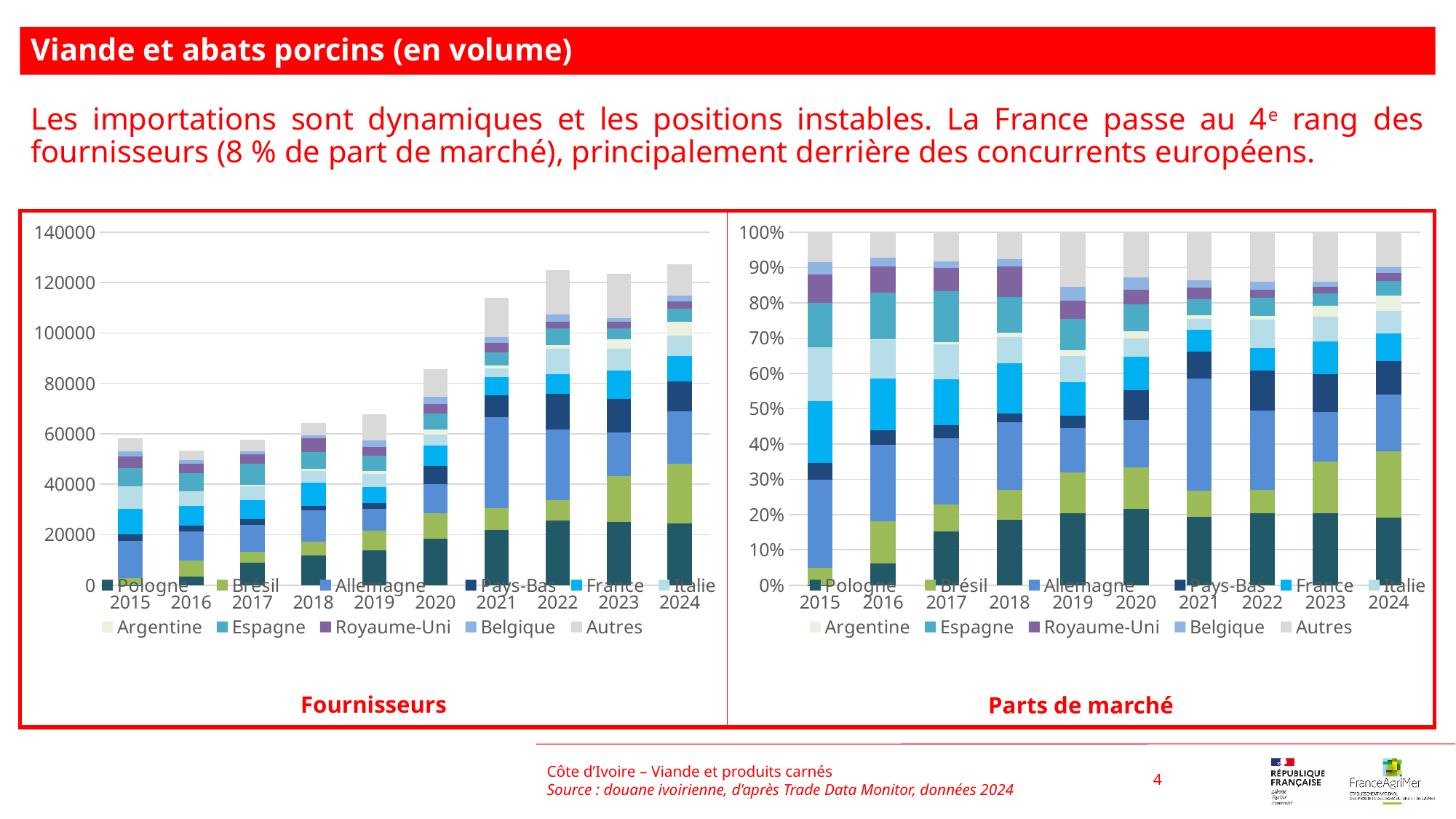
In the 'Fournisseurs' chart, do the total stacked values generally rise or fall from 2015 to 2024? rise In the 'Fournisseurs' chart, which year has a larger total stacked value, 2019 or 2021? 2021 Which series is listed last in the legend of the 'Fournisseurs' chart? Autres What kind of chart is the 'Fournisseurs' chart on the left? Stacked bar chart In the 'Fournisseurs' chart, is the total stacked value for 2015 greater or less than 60000? less In the 'Fournisseurs' chart, is the total stacked value for 2024 greater or less than 120000? greater In the 'Fournisseurs' chart, is the total stacked value for 2020 greater or less than 80000? greater What is the title shown under the right-hand chart? Parts de marché How many series does the legend of the 'Parts de marché' chart list? 11 How many years are shown on the x axis of the 'Fournisseurs' chart? 10 In the 'Fournisseurs' chart, which year has the lowest total stacked value? 2016